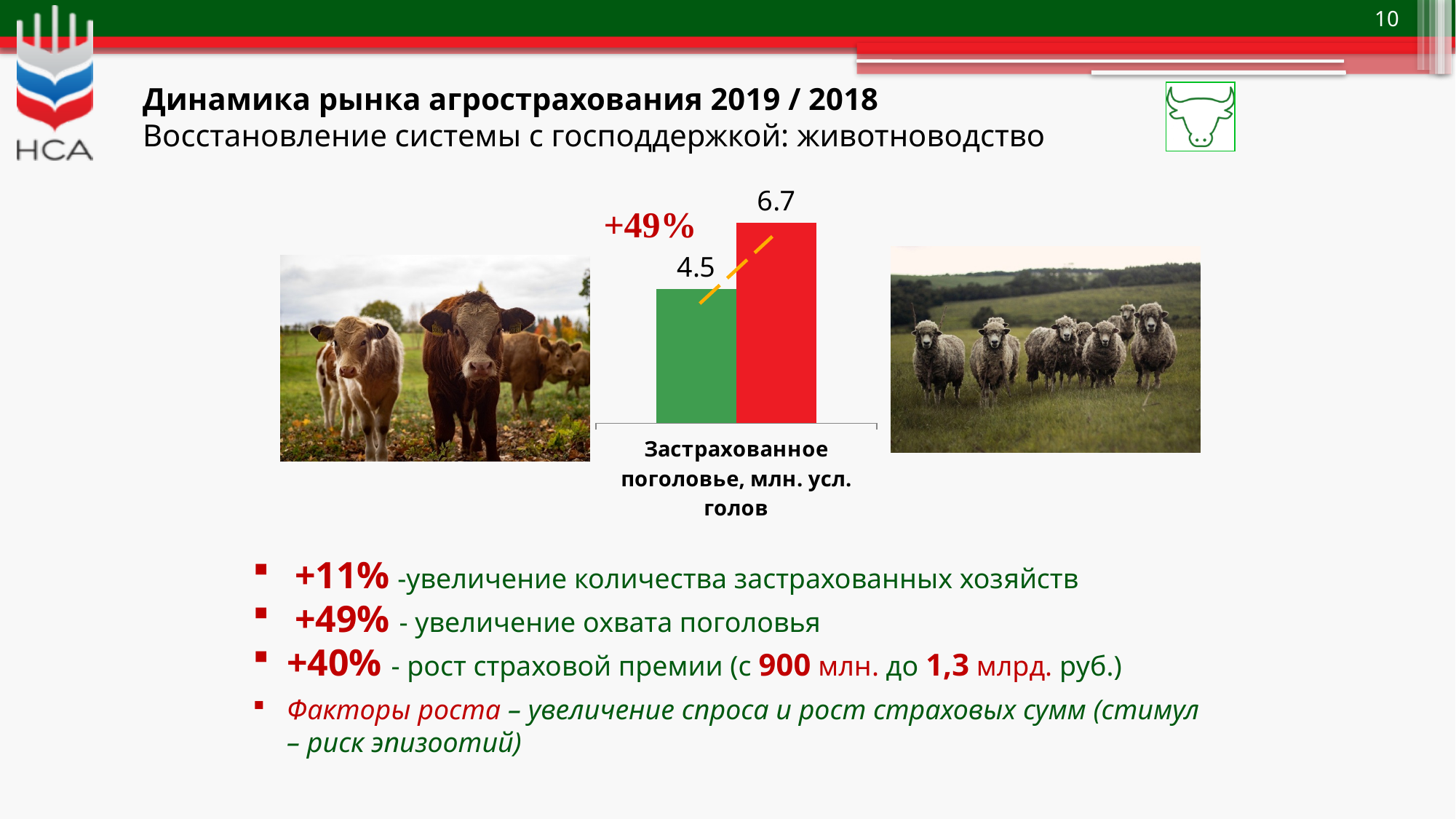
What type of chart is shown on the slide? bar chart What is the highest value shown in the chart? 6.7 Which bar in the chart has the higher value, the green one or the red one? the red one What is the value shown on the green bar in the chart? 4.5 What is the value shown on the red bar in the chart? 6.7 What is the difference between the red bar value and the green bar value in the chart? 2.2 What is the lowest value shown in the chart? 4.5 What is the category label written under the bars in the chart? Застрахованное поголовье, млн. усл. голов What percentage change is annotated above the bars in the chart? +49% How many bars are plotted in the chart? 2 Do the bar values rise or fall from left to right in the chart? rise